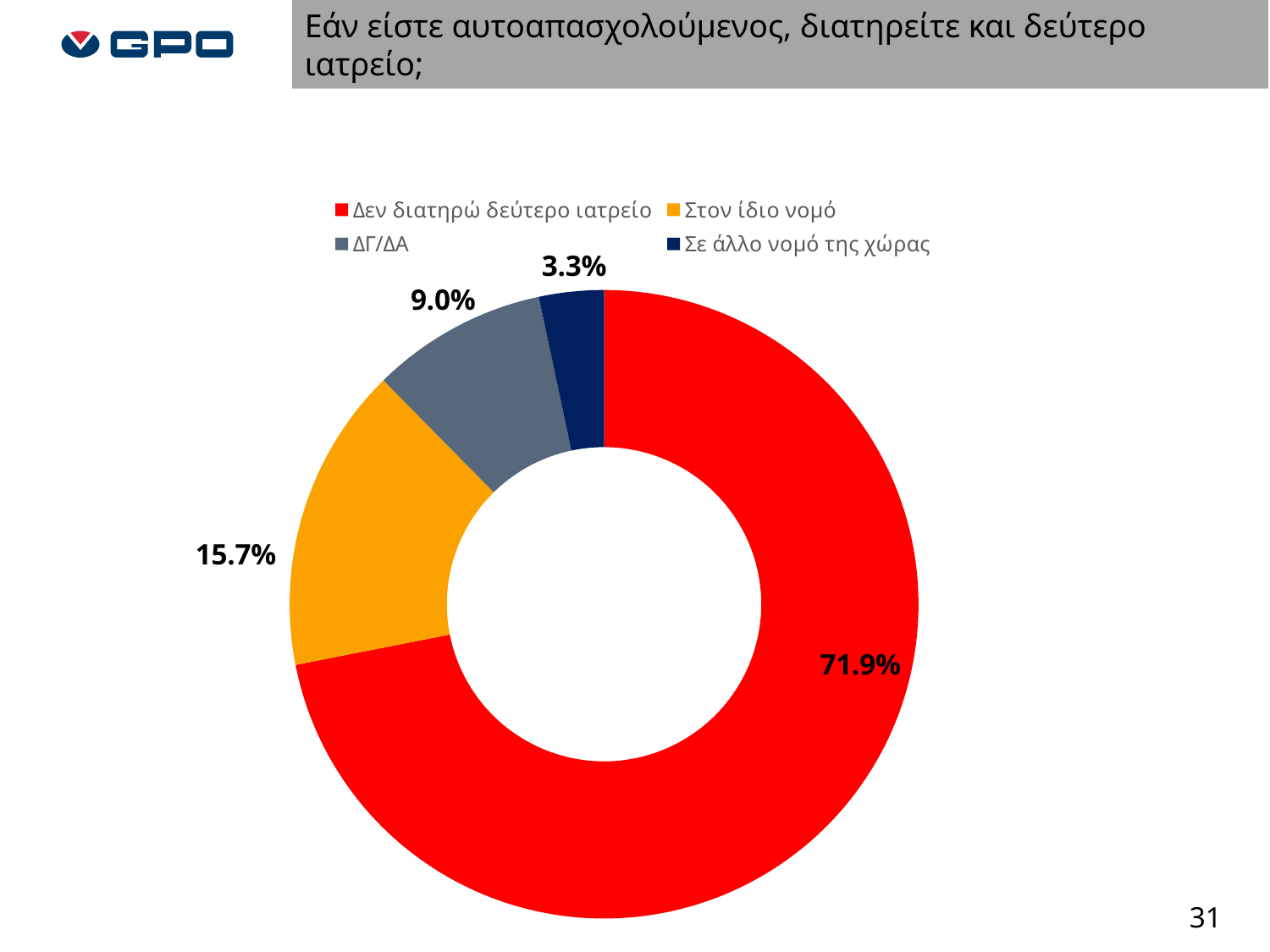
Which category has the largest share? Δεν διατηρώ δεύτερο ιατρείο What is the value for 'Στον ίδιο νομό'? 15.7% What colour is the slice for 'Στον ίδιο νομό'? Orange What is the value for 'ΔΓ/ΔΑ'? 9.0% Which category has the smallest share? Σε άλλο νομό της χώρας How many categories does the chart show? 4 What is the difference in percentage points between 'Στον ίδιο νομό' and 'ΔΓ/ΔΑ'? 6.7 Which is larger: 'Στον ίδιο νομό' or 'Σε άλλο νομό της χώρας'? Στον ίδιο νομό What kind of chart is shown on the slide? Doughnut (pie) chart What is the value for 'Σε άλλο νομό της χώρας'? 3.3% What is the combined share of 'Στον ίδιο νομό' and 'Σε άλλο νομό της χώρας'? 19.0% What percentage of respondents answered 'Δεν διατηρώ δεύτερο ιατρείο'? 71.9%